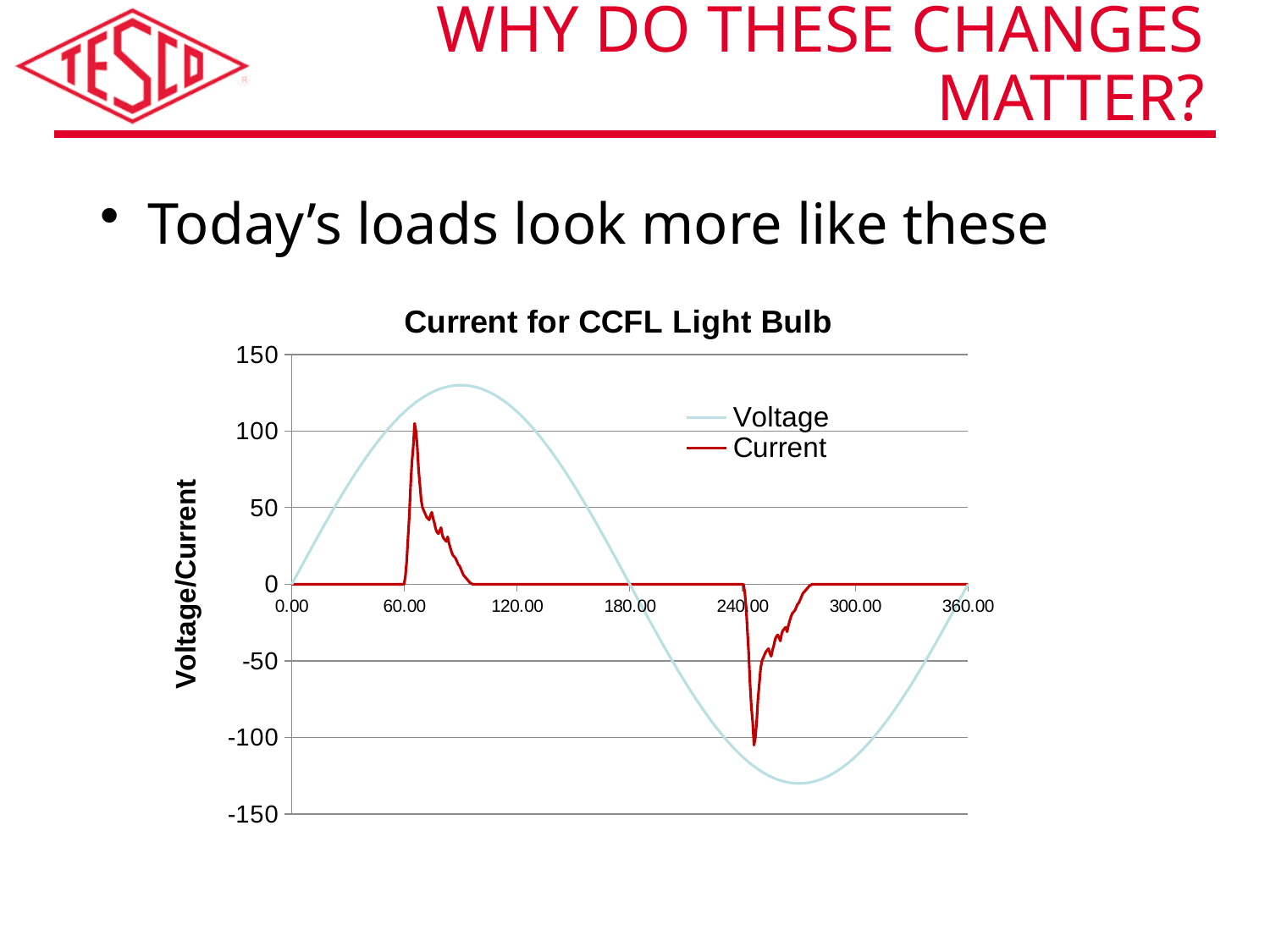
How many series does the legend of the chart list? 2 What is the title of the chart? Current for CCFL Light Bulb What are the two series named in the chart legend? Voltage and Current Does the Voltage series rise or fall between 180.00 and 240.00 on the x axis? fall Which series reaches a higher peak value, Voltage or Current? Voltage Does the Voltage series rise or fall between 0.00 and 60.00 on the x axis? rise Is the lowest value of the Voltage series greater or less than -100? less Is the peak value of the Current series greater or less than 50? greater Is the peak value of the Voltage series greater or less than 100? greater What kind of chart is shown on the slide? line chart What is the value of the Current series at 120.00 on the x axis? 0